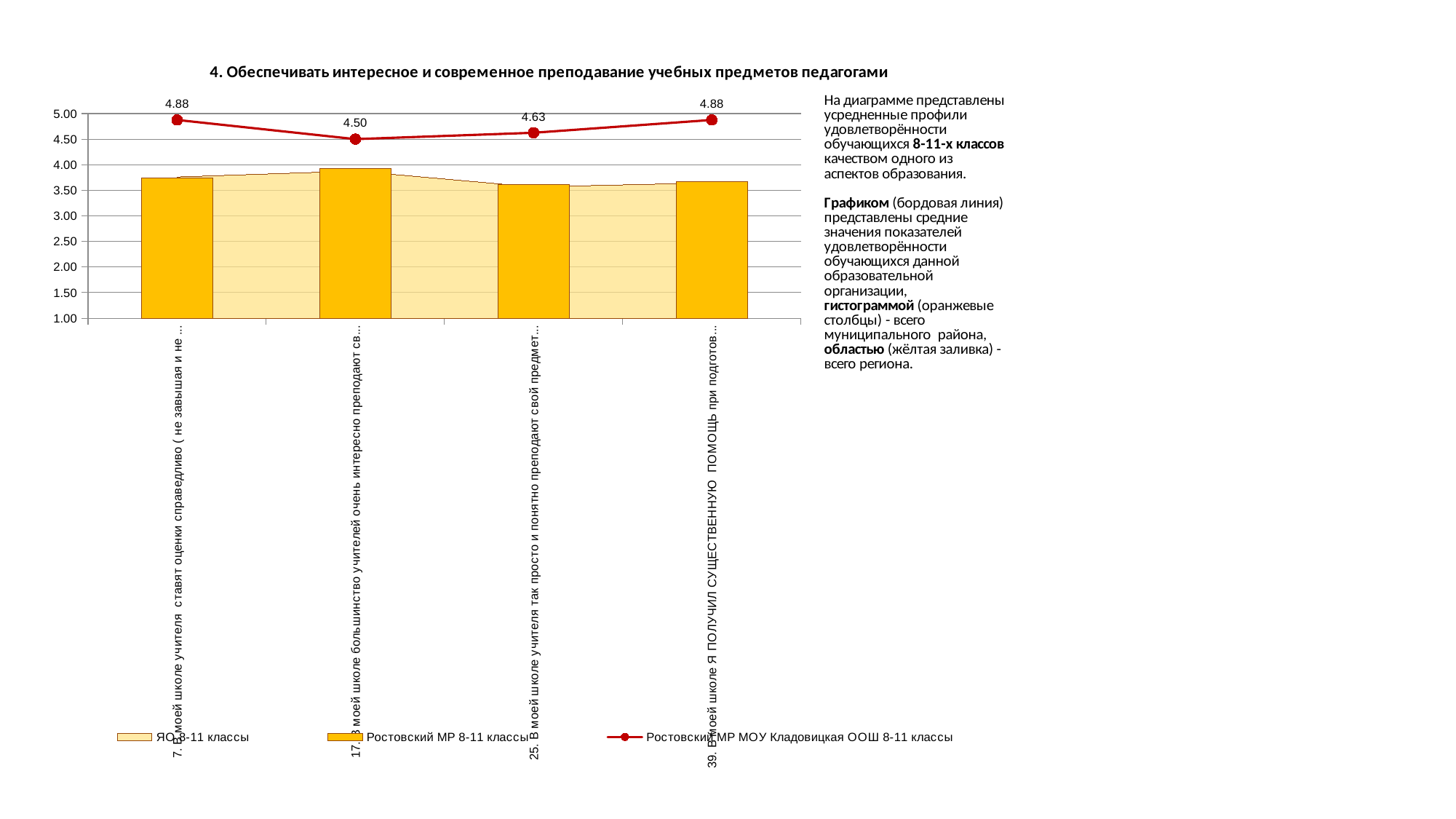
How many categories are shown on the x axis? 4 For which category is the Ростовский МР 8-11 классы bar highest? 17. How many series does the legend list? 3 What is the value of the Ростовский МР МОУ Кладовицкая ООШ 8-11 классы line for the third category (25.)? 4.63 Which has the larger line value, category 17. or category 25.? 25. Is the Ростовский МР 8-11 классы bar for category 17. greater or less than 3.50? greater What is the difference between the line values for category 7. and category 17.? 0.38 What is the value of the Ростовский МР МОУ Кладовицкая ООШ 8-11 классы line for the second category (17.)? 4.50 What is the difference between the line values for category 25. and category 17.? 0.13 Is the Ростовский МР 8-11 классы bar for category 25. greater or less than 4.00? less What is the value of the Ростовский МР МОУ Кладовицкая ООШ 8-11 классы line for the first category (7.)? 4.88 For which category is the Ростовский МР МОУ Кладовицкая ООШ 8-11 классы line lowest? 17.